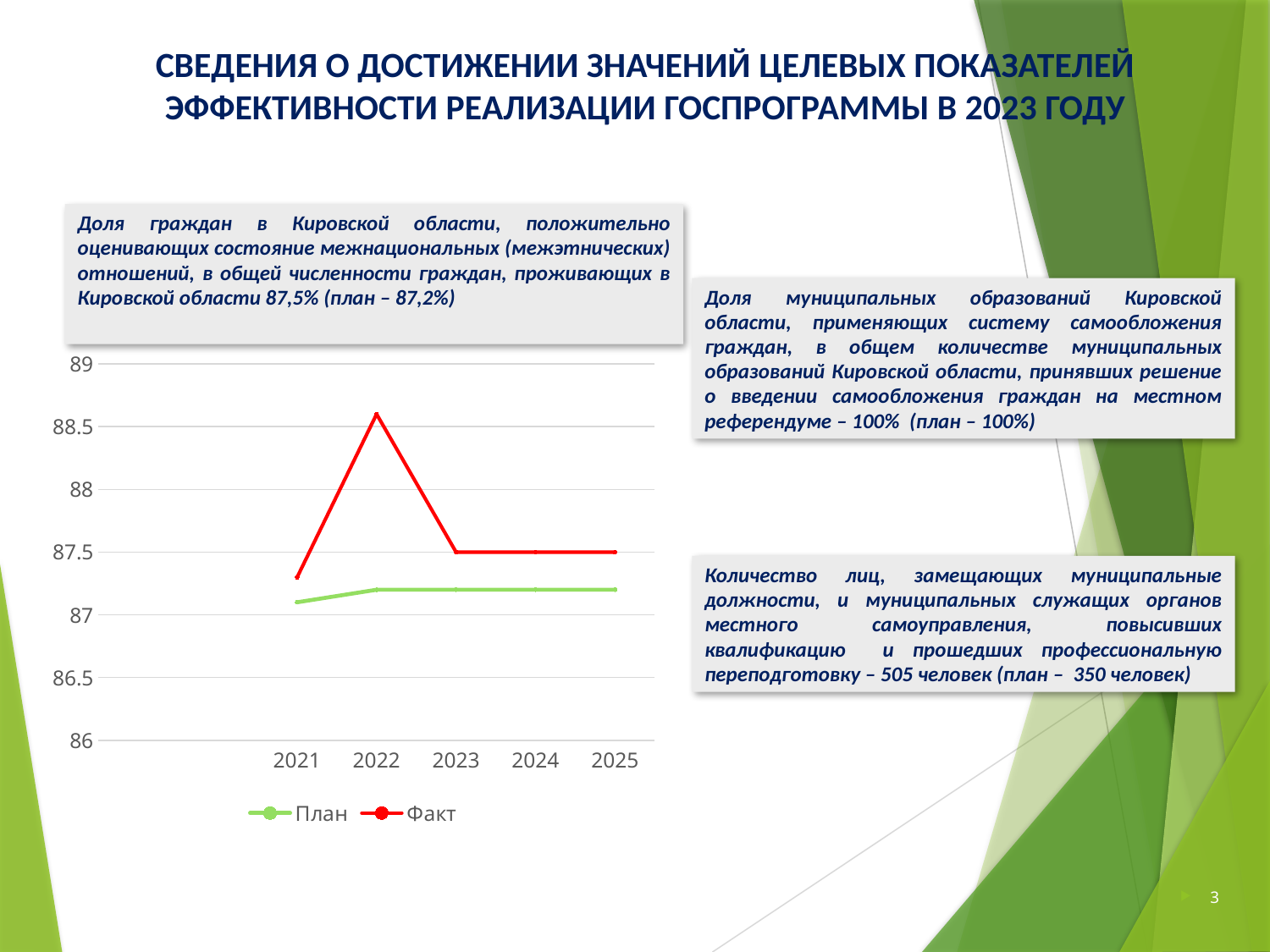
Is the value of the Факт series in 2022 greater or less than 88? greater In which year is the Факт series at its lowest value? 2021 What is the value of the Факт series in 2023? 87.5 How many series does the chart legend list? 2 How many years are plotted along the x axis of the chart? 5 What are the names of the two series in the chart legend? План and Факт Is the value of the План series in 2021 greater or less than 87.5? less In 2022, which series has the larger value, План or Факт? Факт What colour is the line for the Факт series? red In which year does the Факт series reach its highest value? 2022 What kind of chart is shown on the slide? line chart Does the Факт series rise or fall from 2022 to 2023? fall